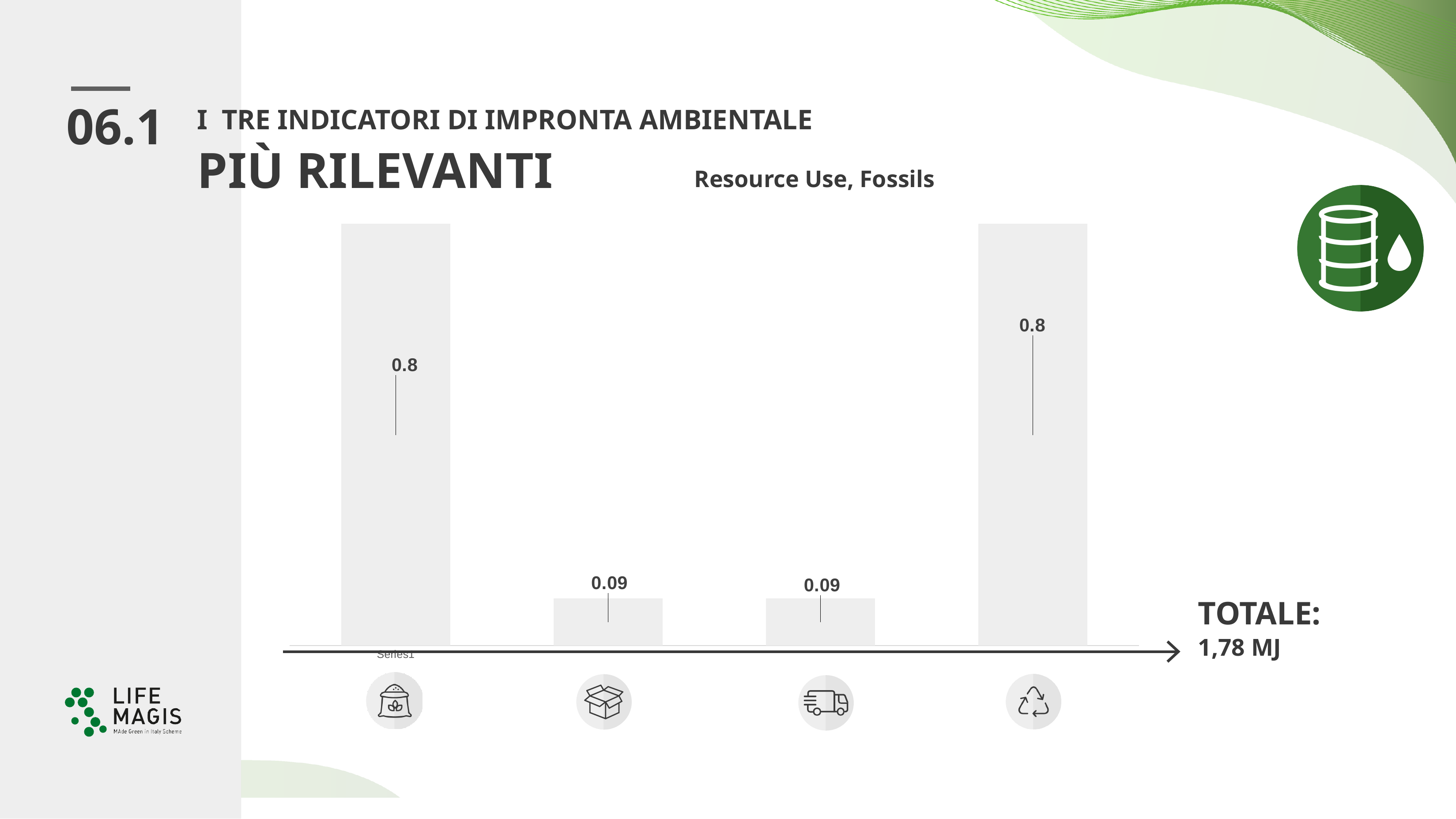
What is the difference between the first bar and the second bar? 0.71 What is the value of the second bar from the left in the chart? 0.09 How many bars does the chart show? 4 Which bars share the lowest value in the chart? The second and third bars (0.09) What total is stated next to the chart? 1,78 MJ What is the value of the bar above the truck icon? 0.09 What is the title of the chart? Resource Use, Fossils Which bars share the highest value in the chart? The first and fourth bars (0.8) What kind of chart is shown on the slide? Bar chart What is the value of the bar above the recycling icon? 0.8 Which is larger: the bar above the box icon or the bar above the recycling icon? The bar above the recycling icon What is the value of the first (leftmost) bar in the chart? 0.8